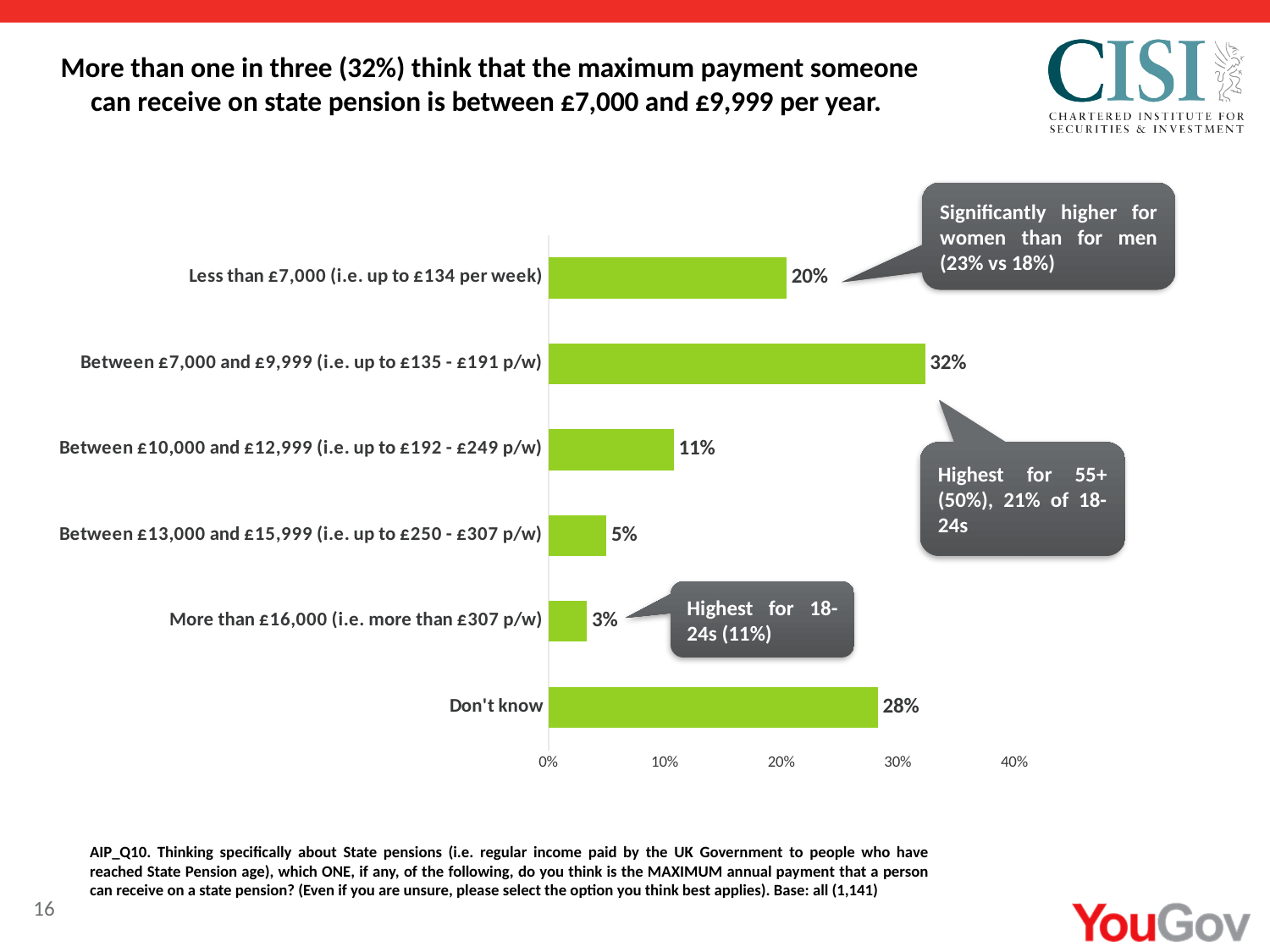
What is the difference between the values for "Less than £7,000" and "Between £10,000 and £12,999"? 9% What is the difference between the values for "Between £7,000 and £9,999" and "Don't know"? 4% How many categories are shown in the chart? 6 What is the highest value shown on the x axis? 40% Which category has the lowest value? More than £16,000 (i.e. more than £307 p/w) What percentage of respondents think the maximum state pension payment is between £7,000 and £9,999? 32% Which category has the highest value? Between £7,000 and £9,999 (i.e. up to £135 - £191 p/w) What is the value for "More than £16,000 (i.e. more than £307 p/w)"? 3% Is the value for "Between £13,000 and £15,999" greater or less than 10%? less What percentage of respondents answered "Don't know"? 28% Which is larger: the value for "Less than £7,000" or the value for "Don't know"? Don't know What kind of chart is shown on the slide? Bar chart